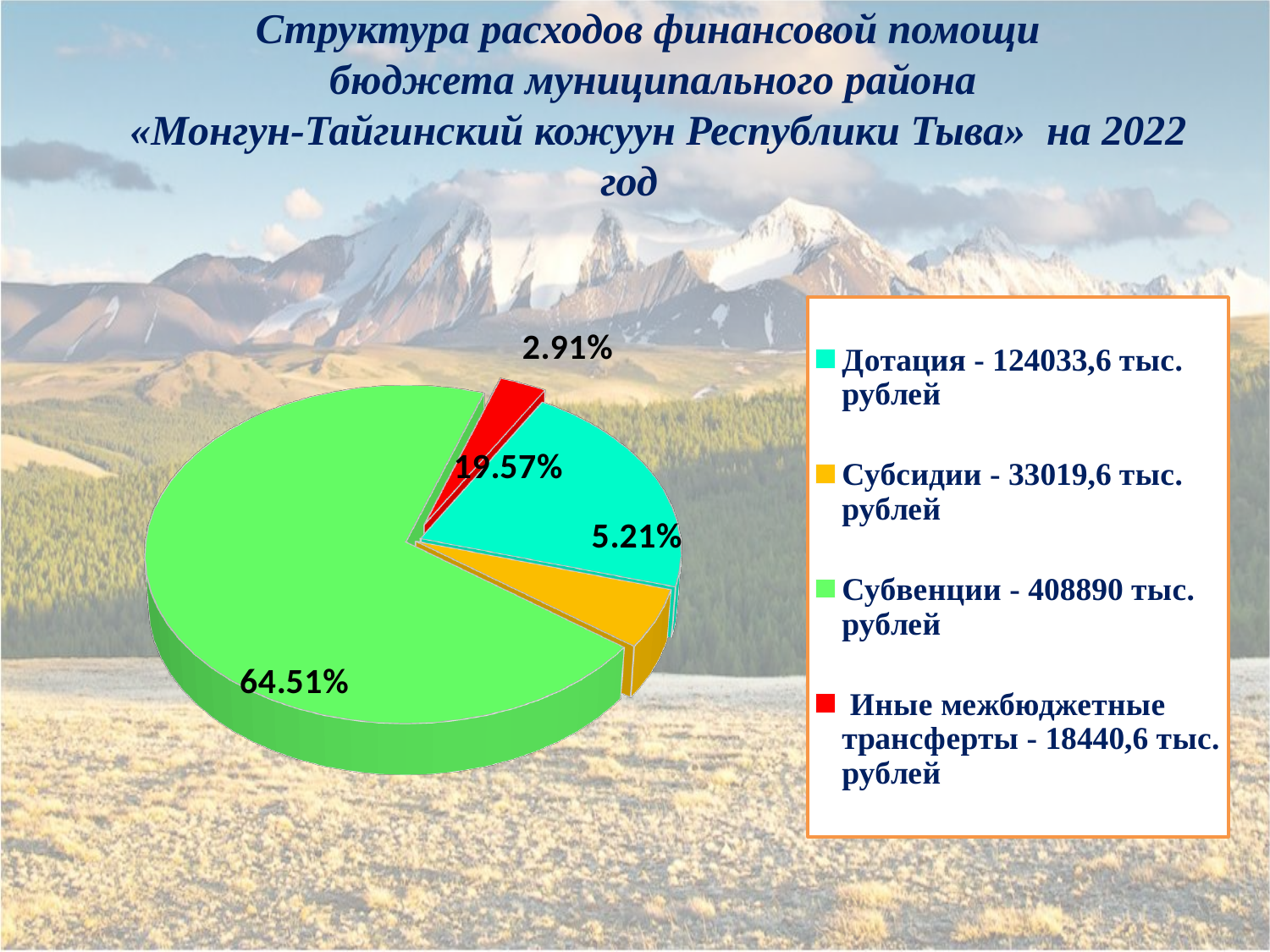
Which is larger, the Субсидии slice or the Дотация slice? Дотация How many slices does the pie chart have? 4 How many entries does the legend list? 4 What share of the pie does Субвенции take? 64.51% What kind of chart is shown on the slide? pie chart What share of the pie does Иные межбюджетные трансферты take? 2.91% What share of the pie does Дотация take? 19.57% Which category has the smallest slice of the pie? Иные межбюджетные трансферты Which category has the largest slice of the pie? Субвенции According to the legend, what amount is given for Субсидии? 33019,6 тыс. рублей What is the difference in percentage points between the Субвенции slice and the Дотация slice? 44.94%